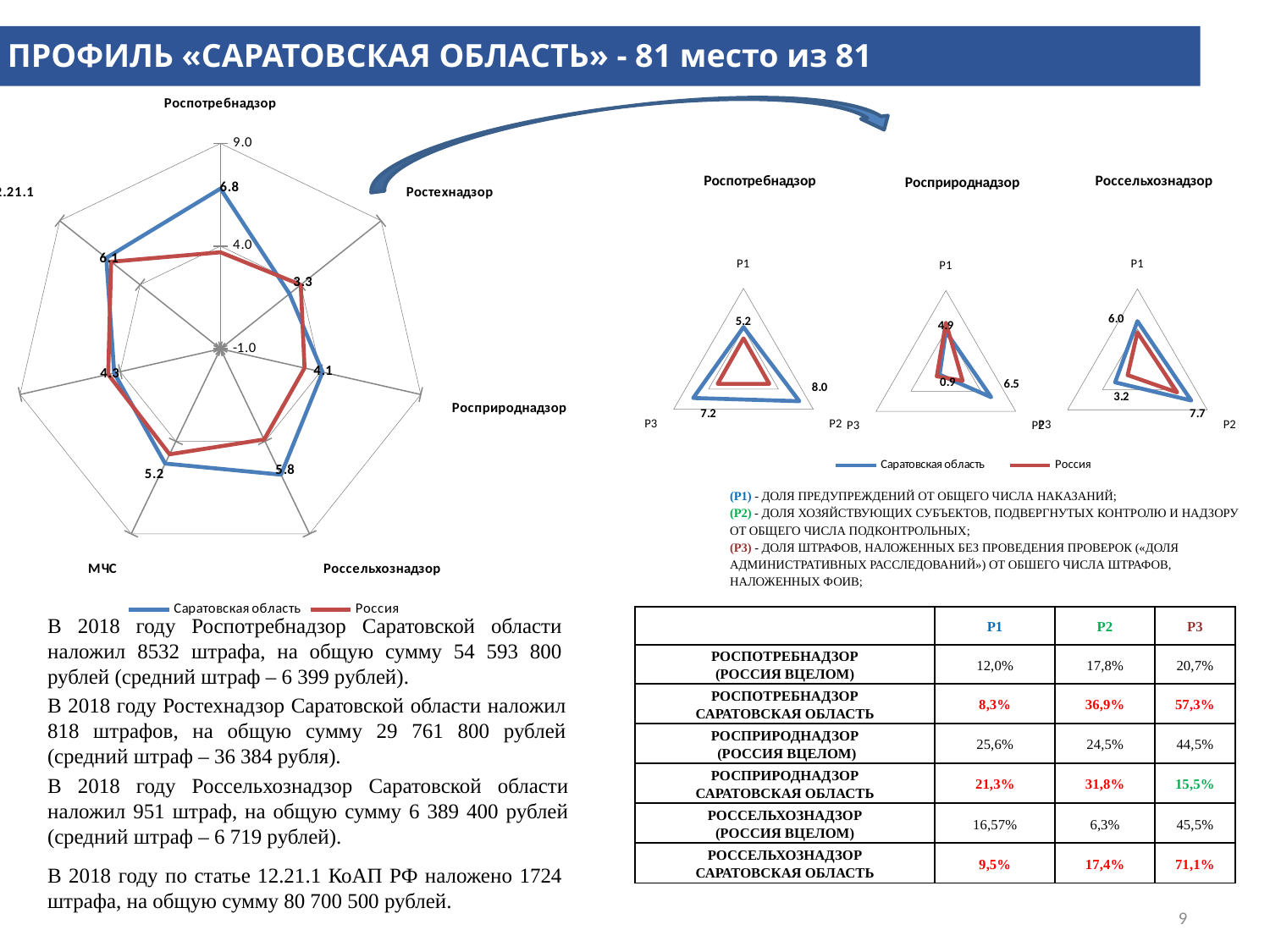
How many series does the legend of the large radar chart on the left list? 2 How many axes (categories) does the small radar chart titled Росприроднадзор have? 3 On the small radar chart titled Роспотребнадзор, which is larger for Саратовская область: P2 or P3? P2 On the small radar chart titled Росприроднадзор, which axis has the lowest value for Саратовская область? P3 On the large radar chart on the left, what is the value for Саратовская область on the Роспотребнадзор axis? 6.8 On the large radar chart on the left, which labelled axis has the lowest value for Саратовская область? Ростехнадзор On the large radar chart on the left, which labelled axis has the highest value for Саратовская область? Роспотребнадзор On the large radar chart on the left, what is the difference between the Саратовская область values for Роспотребнадзор and Ростехнадзор? 3.5 On the small radar chart titled Роспотребнадзор, what is the value for Саратовская область at P2? 8.0 What kind of chart is the large chart on the left of the slide? radar chart On the small radar chart titled Россельхознадзор, what is the value for Саратовская область at P2? 7.7 On the large radar chart on the left, what is the value for Саратовская область on the Ростехнадзор axis? 3.3